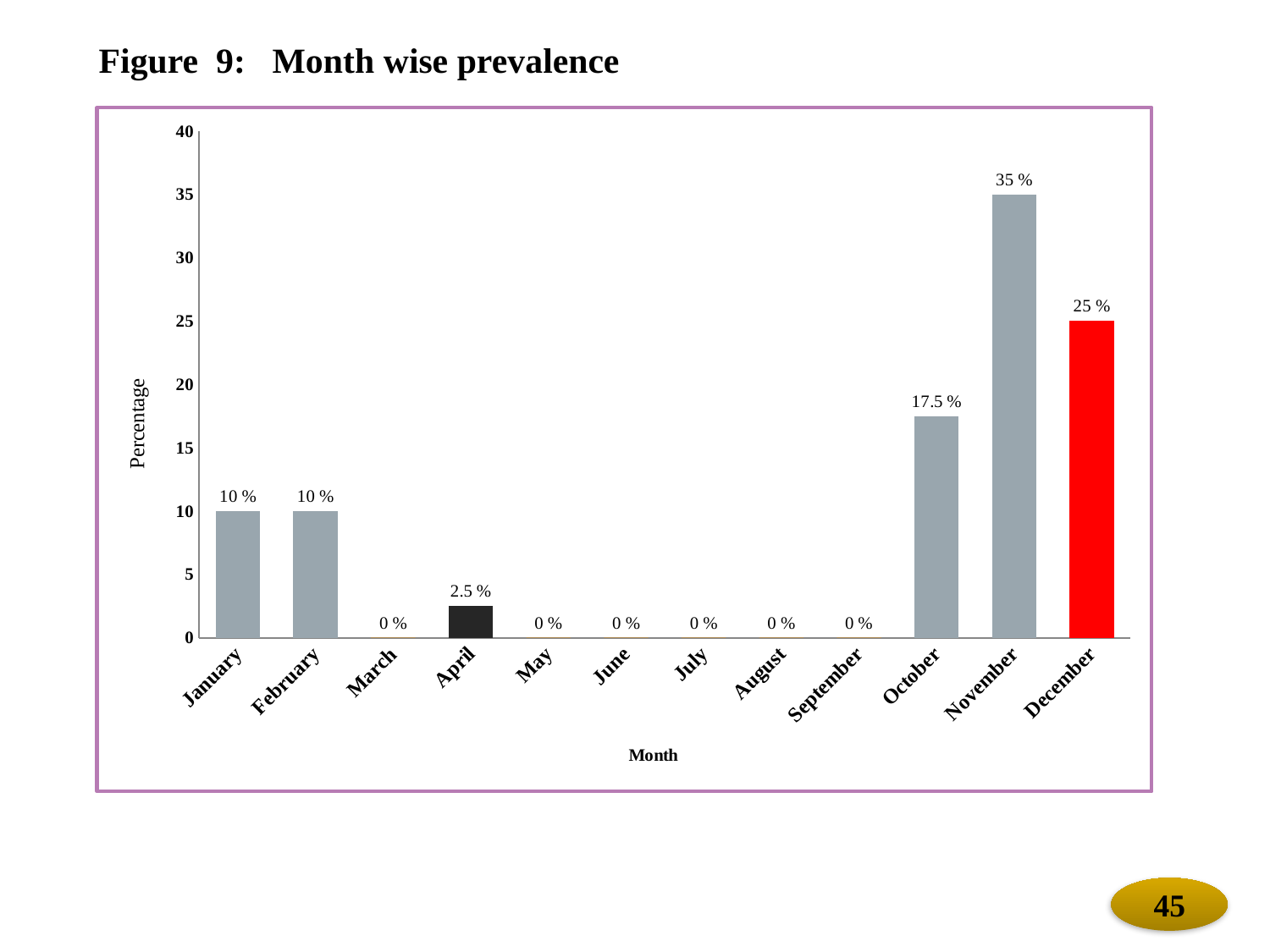
What is the prevalence percentage for October? 17.5 % Is the value for November greater or less than 30? greater What is the difference in prevalence between November and December? 10 % Which has a higher prevalence, October or December? December What is the prevalence percentage for April? 2.5 % What kind of chart is shown on the slide? Bar chart What is the difference in prevalence between December and October? 7.5 % How many months have a prevalence of 0 %? 6 What is the label of the y axis? Percentage Which month has the highest prevalence? November How many months are shown on the x axis? 12 What is the prevalence percentage for November? 35 %